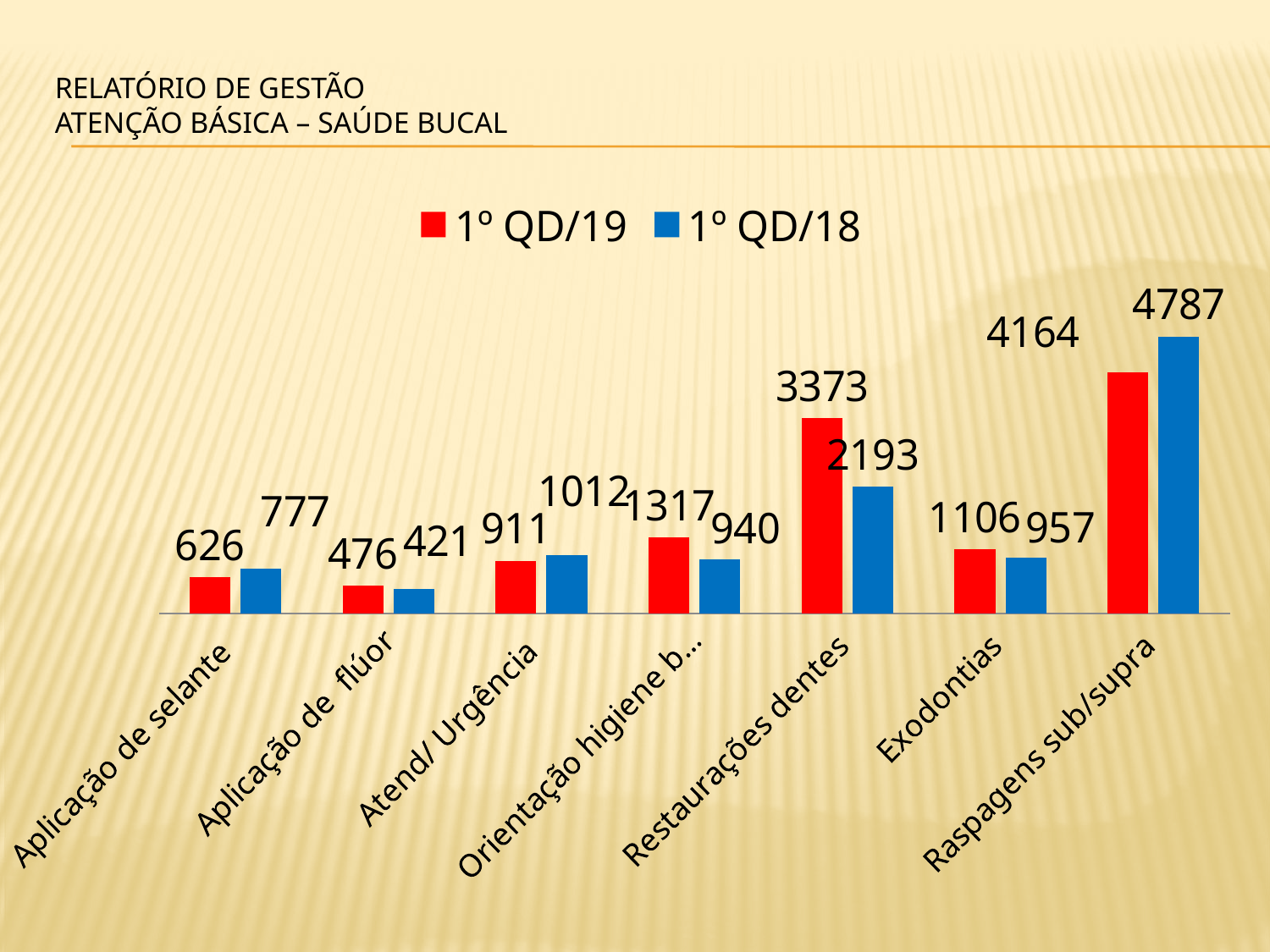
What is the difference between the 1º QD/19 and 1º QD/18 values for Restaurações dentes? 1180 How many categories are shown on the x axis? 7 Which category has the lowest value in the 1º QD/19 series? Aplicação de flúor For Atend/ Urgência, which series has the larger value, 1º QD/19 or 1º QD/18? 1º QD/18 For Exodontias, is the 1º QD/19 value larger or smaller than the 1º QD/18 value? larger What is the value for Aplicação de selante in the 1º QD/18 series? 777 Which category has the highest value in the 1º QD/18 series? Raspagens sub/supra What is the value for Exodontias in the 1º QD/19 series? 1106 What kind of chart is shown on the slide? bar chart How many series does the legend list? 2 What is the 1º QD/18 value for Restaurações dentes? 2193 What is the difference between the 1º QD/18 and 1º QD/19 values for Raspagens sub/supra? 623